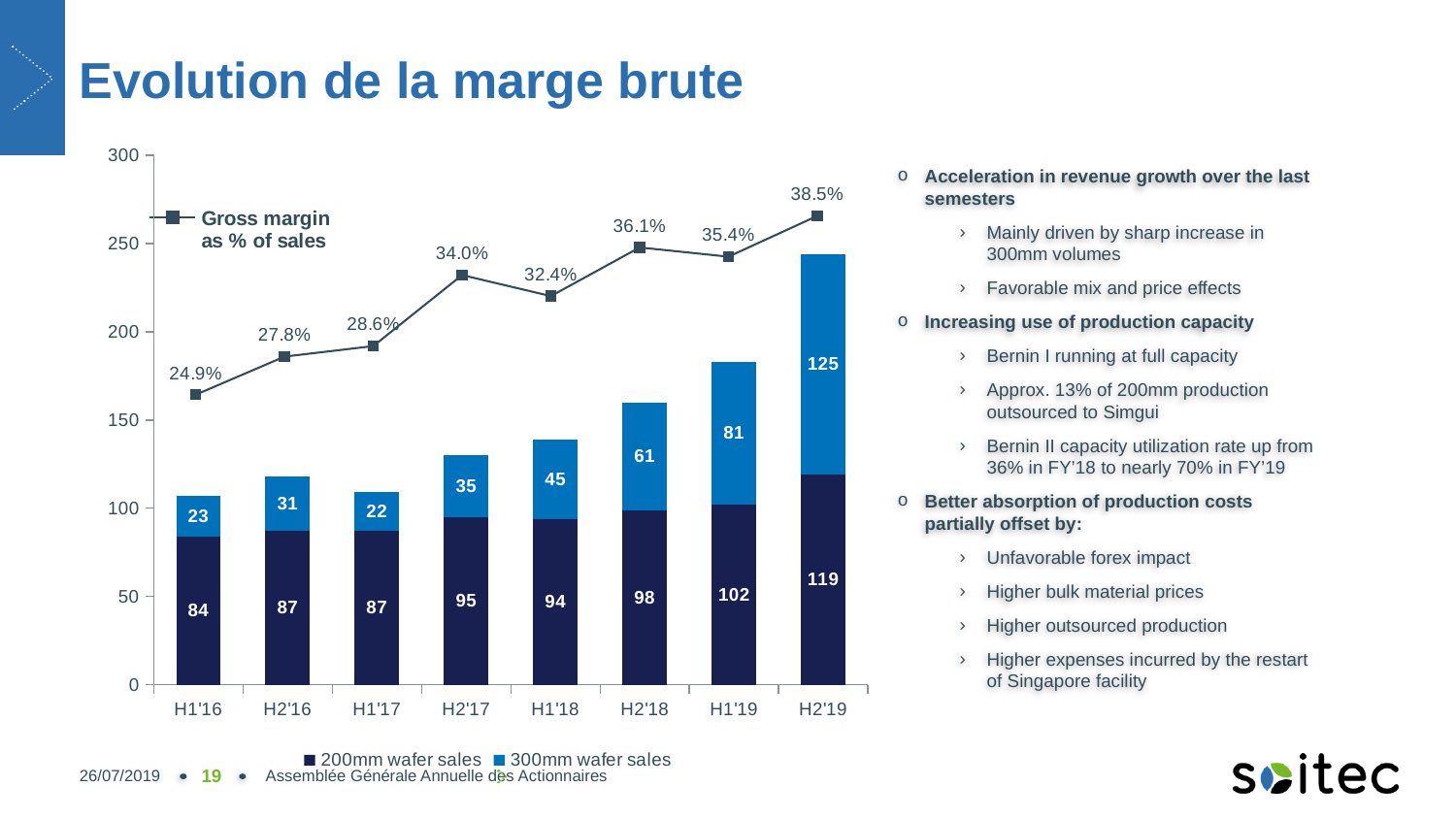
How many periods are shown on the x axis? 8 What is the value of 300mm wafer sales for H1'18? 45 What is the gross margin as % of sales for H2'17? 34.0% How many series does the legend at the bottom of the chart list? 2 Which is larger: 200mm wafer sales in H2'18 or 300mm wafer sales in H2'18? 200mm wafer sales What is the difference between 300mm wafer sales in H2'19 and H1'19? 44 Which period has the lowest 300mm wafer sales? H1'17 What kind of chart is used to show the wafer sales? Stacked bar chart Which period has the highest gross margin as % of sales? H2'19 What is the total of the stacked bar for H1'19? 183 Does the gross margin as % of sales generally rise or fall from H1'16 to H2'19? Rise What is the value of 200mm wafer sales for H2'19? 119